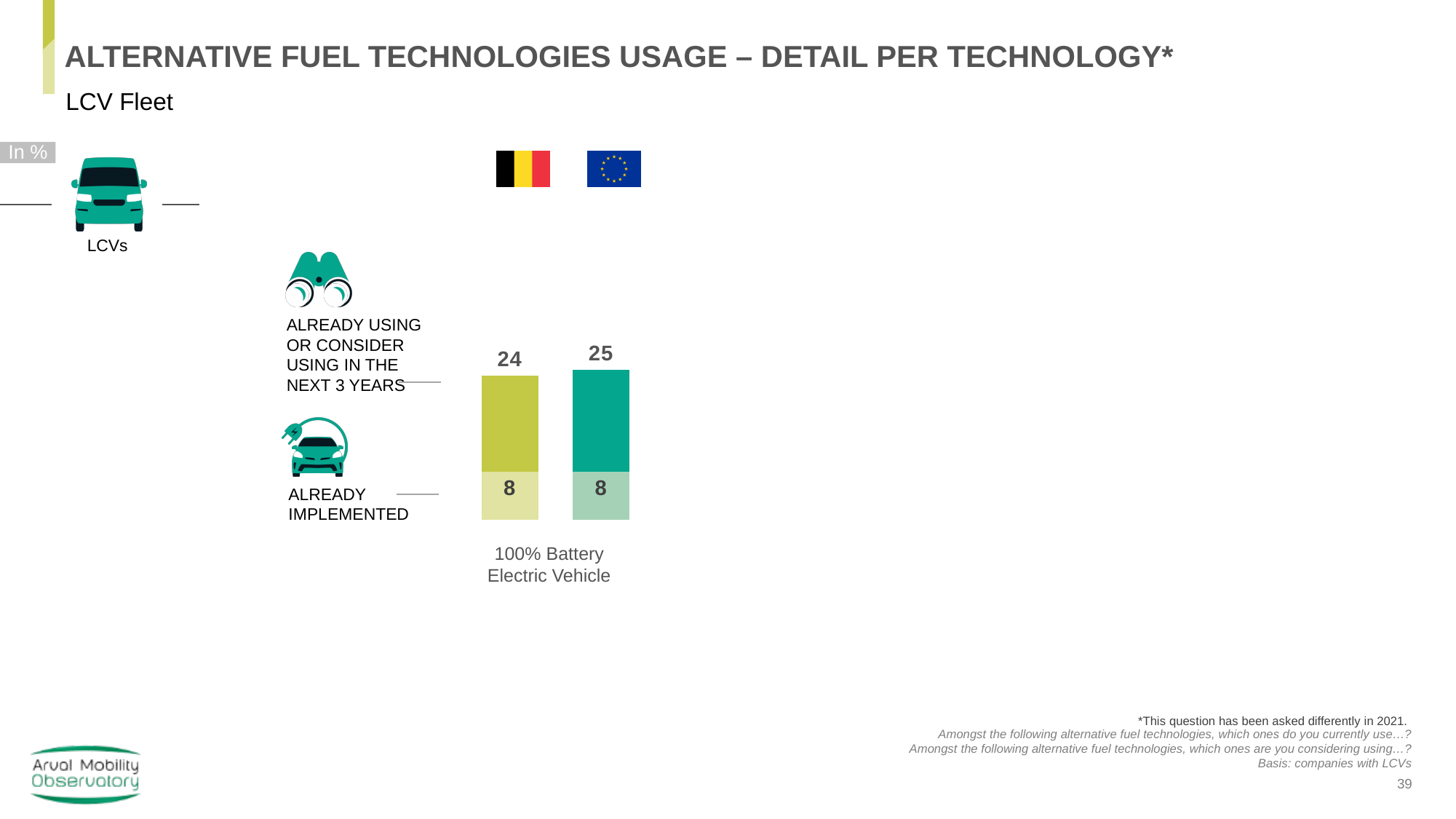
What is the 'already implemented' value for the bar under the Belgian flag? 8 Which bar has the higher 'already using or consider using in the next 3 years' value, the one under the Belgian flag or the one under the EU flag? EU flag Is the 'already using or consider using in the next 3 years' value for the Belgian flag bar greater or less than 20? greater In what unit are the values on the chart expressed? % What is the 'already implemented' value for the bar under the EU flag? 8 What is the 'already using or consider using in the next 3 years' value for the bar under the EU flag? 25 What is the 'already using or consider using in the next 3 years' value for the bar under the Belgian flag? 24 Which alternative fuel technology is the chart about? 100% Battery Electric Vehicle What type of chart is shown on the slide? Bar chart What is the difference between the 'already using or consider using in the next 3 years' values for the EU flag bar and the Belgian flag bar? 1 How many bars are shown in the chart? 2 What is the difference between the 'already implemented' values for the Belgian flag bar and the EU flag bar? 0